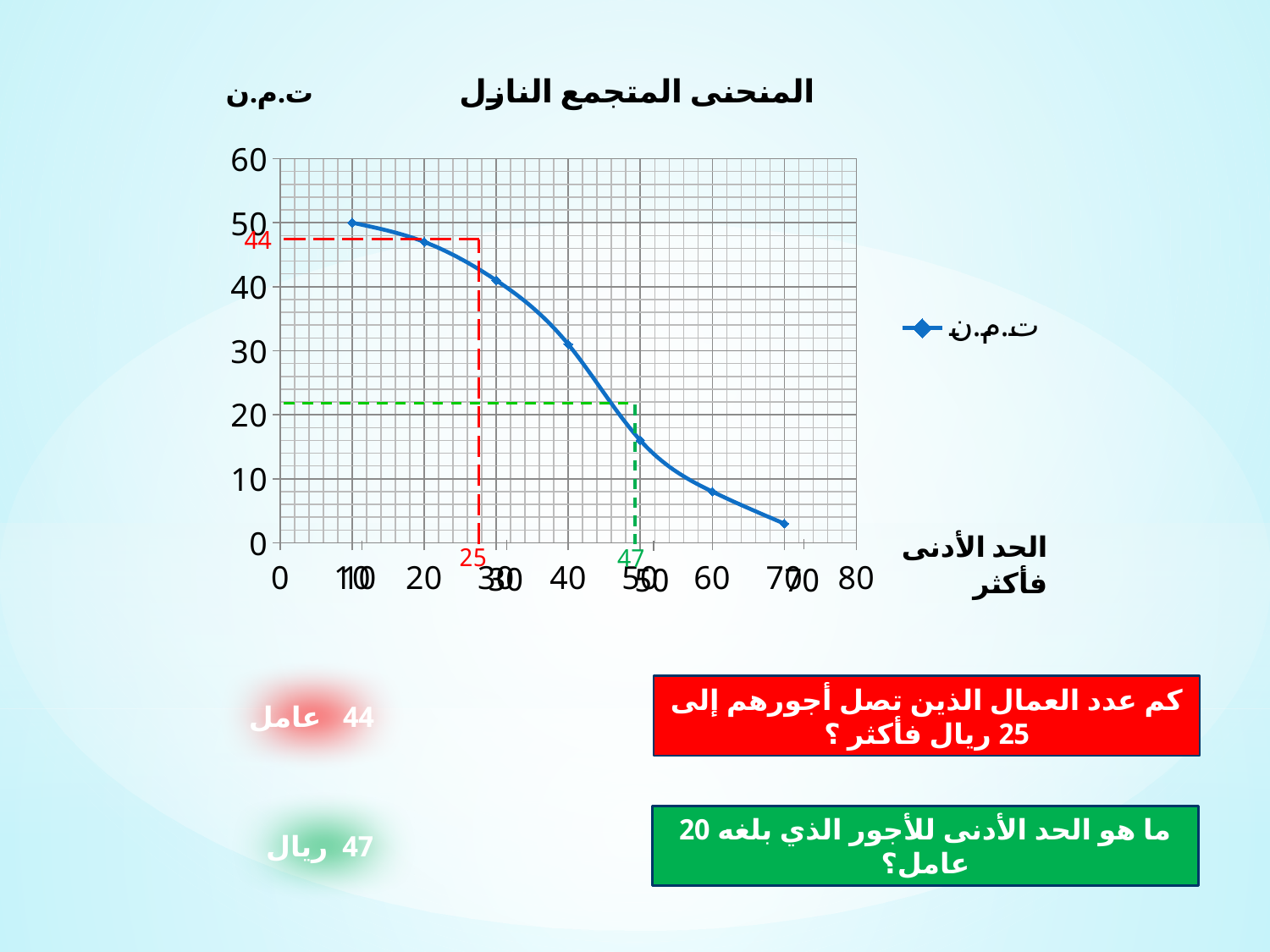
Is the value at x = 10 greater or less than 40? greater Do the values rise or fall as the x axis increases? fall What kind of chart is shown on the slide? line chart According to the red dashed annotation, what y value corresponds to x = 25? 44 How many series does the legend list? 1 How many data points are plotted on the curve? 7 Is the value at x = 50 greater or less than 20? less Which is larger, the value at x = 20 or the value at x = 60? x = 20 At which x-axis value is the curve lowest? 70 At which x-axis value is the curve highest? 10 What is the title of the chart? المنحنى المتجمع النازل Is the value at x = 40 greater or less than 20? greater